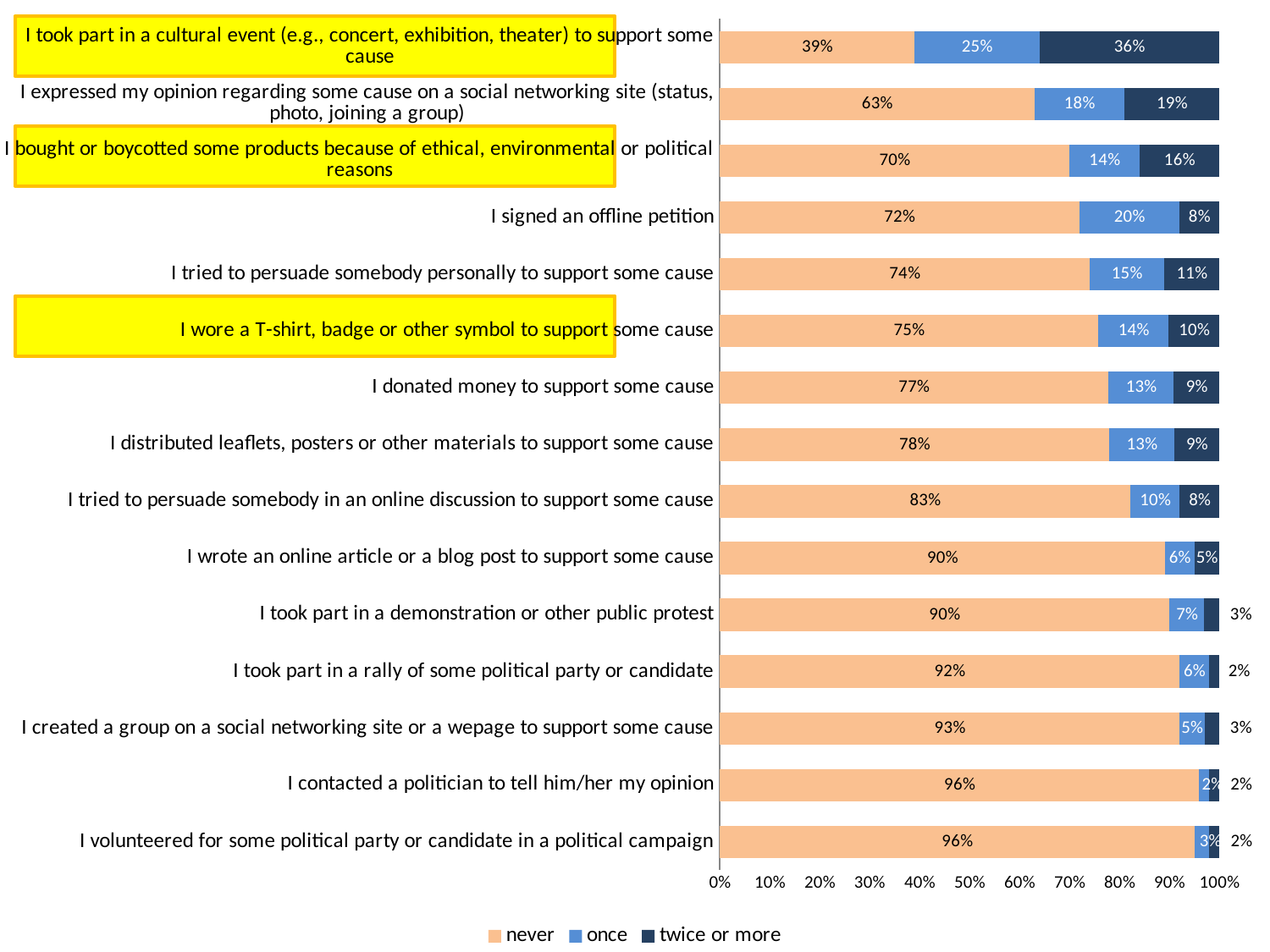
What is the "once" value for "I signed an offline petition"? 20% How many activities (categories) are shown in the chart? 15 Which series is shown in the darkest colour in the legend? twice or more Which is larger: the "once" value for "I tried to persuade somebody personally to support some cause" or the "once" value for "I donated money to support some cause"? I tried to persuade somebody personally to support some cause How many series does the legend list? 3 What kind of chart is shown on the slide? Stacked bar chart What is the "never" value for "I contacted a politician to tell him/her my opinion"? 96% What percentage of respondents answered "never" for "I took part in a cultural event (e.g., concert, exhibition, theater) to support some cause"? 39% What is the difference between the "never" values for "I bought or boycotted some products because of ethical, environmental or political reasons" and "I wore a T-shirt, badge or other symbol to support some cause"? 5% Which activity has the highest "twice or more" value? I took part in a cultural event (e.g., concert, exhibition, theater) to support some cause What is the "twice or more" value for "I expressed my opinion regarding some cause on a social networking site (status, photo, joining a group)"? 19% Which activity has the lowest "never" value? I took part in a cultural event (e.g., concert, exhibition, theater) to support some cause